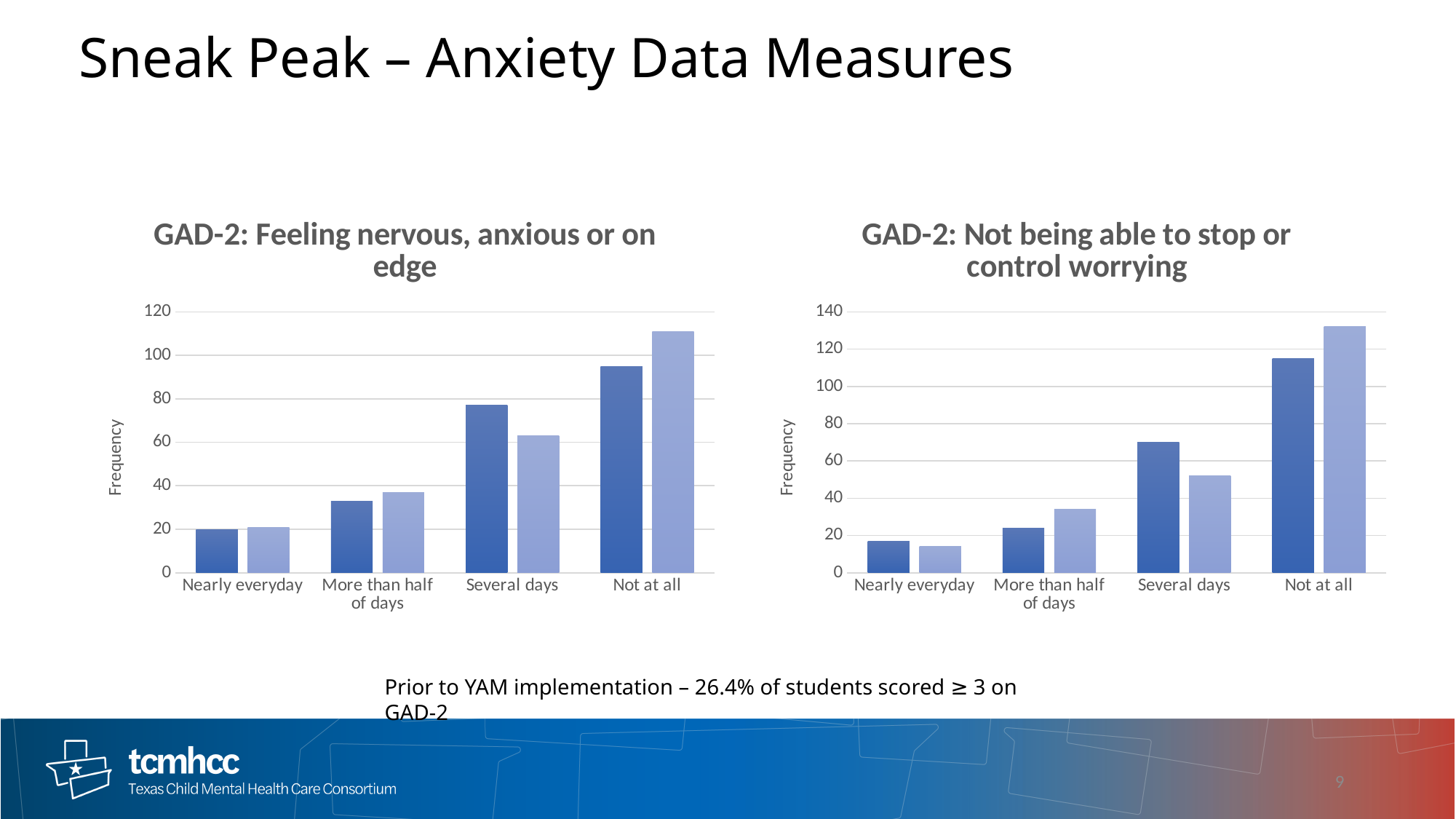
In the 'GAD-2: Feeling nervous, anxious or on edge' chart, is the dark blue bar for 'Not at all' greater or less than 80? greater In the 'GAD-2: Not being able to stop or control worrying' chart, is the dark blue bar for 'More than half of days' greater or less than 40? less How many categories are shown on the x axis of the 'GAD-2: Not being able to stop or control worrying' chart? 4 In the 'GAD-2: Feeling nervous, anxious or on edge' chart, is the light blue bar for 'Several days' greater or less than 80? less In the 'GAD-2: Not being able to stop or control worrying' chart, do the bar heights generally rise or fall moving from 'Nearly everyday' to 'Not at all'? Rise In the 'GAD-2: Feeling nervous, anxious or on edge' chart, for 'Several days', which bar is taller: the dark blue or the light blue? Dark blue In the 'GAD-2: Feeling nervous, anxious or on edge' chart, which category has the tallest bars? Not at all In the 'GAD-2: Not being able to stop or control worrying' chart, for 'Not at all', which bar is taller: the dark blue or the light blue? Light blue What type of chart is the 'GAD-2: Feeling nervous, anxious or on edge' chart? Bar chart In the 'GAD-2: Not being able to stop or control worrying' chart, which category has the shortest bars? Nearly everyday What is the y-axis label on the 'GAD-2: Feeling nervous, anxious or on edge' chart? Frequency